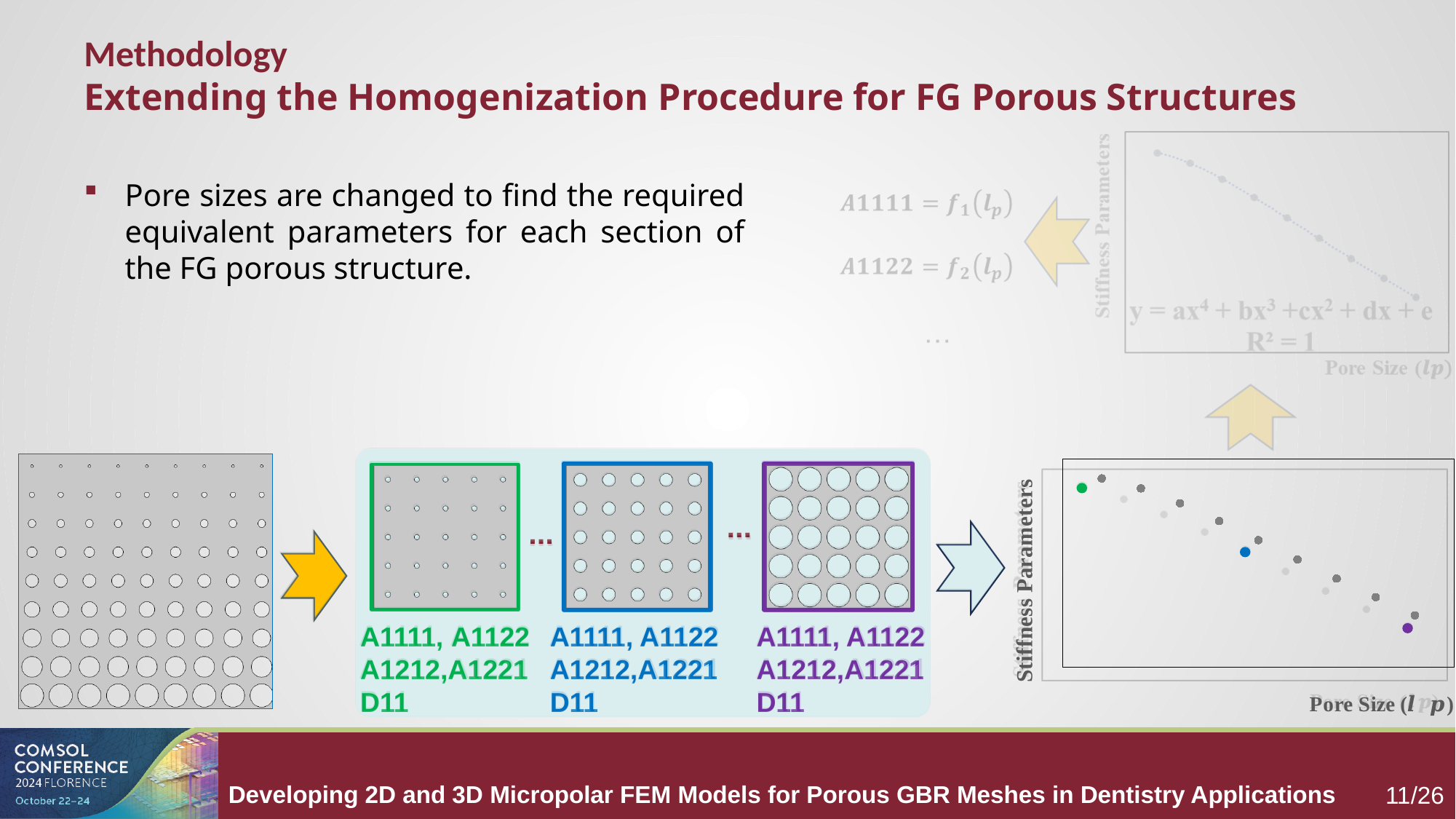
In the bottom-right chart, which coloured point (green, blue or purple) has the highest stiffness parameter value? green In the bottom-right chart, which of the coloured points, green or purple, has the higher stiffness parameter value? green In the bottom-right chart, do the stiffness parameter values rise or fall as pore size increases along the x axis? fall In the bottom-right chart, is the blue point's stiffness parameter value larger or smaller than the purple point's? larger In the bottom-right chart, which coloured point (green, blue or purple) has the lowest stiffness parameter value? purple What kind of chart is the bottom-right chart plotting Stiffness Parameters against Pore Size? scatter chart What R² value is shown for the fitted curve in the top-right chart? R² = 1 In the faded top-right chart, do the plotted values rise or fall as pore size increases? fall What is the label of the y axis on the bottom-right chart? Stiffness Parameters